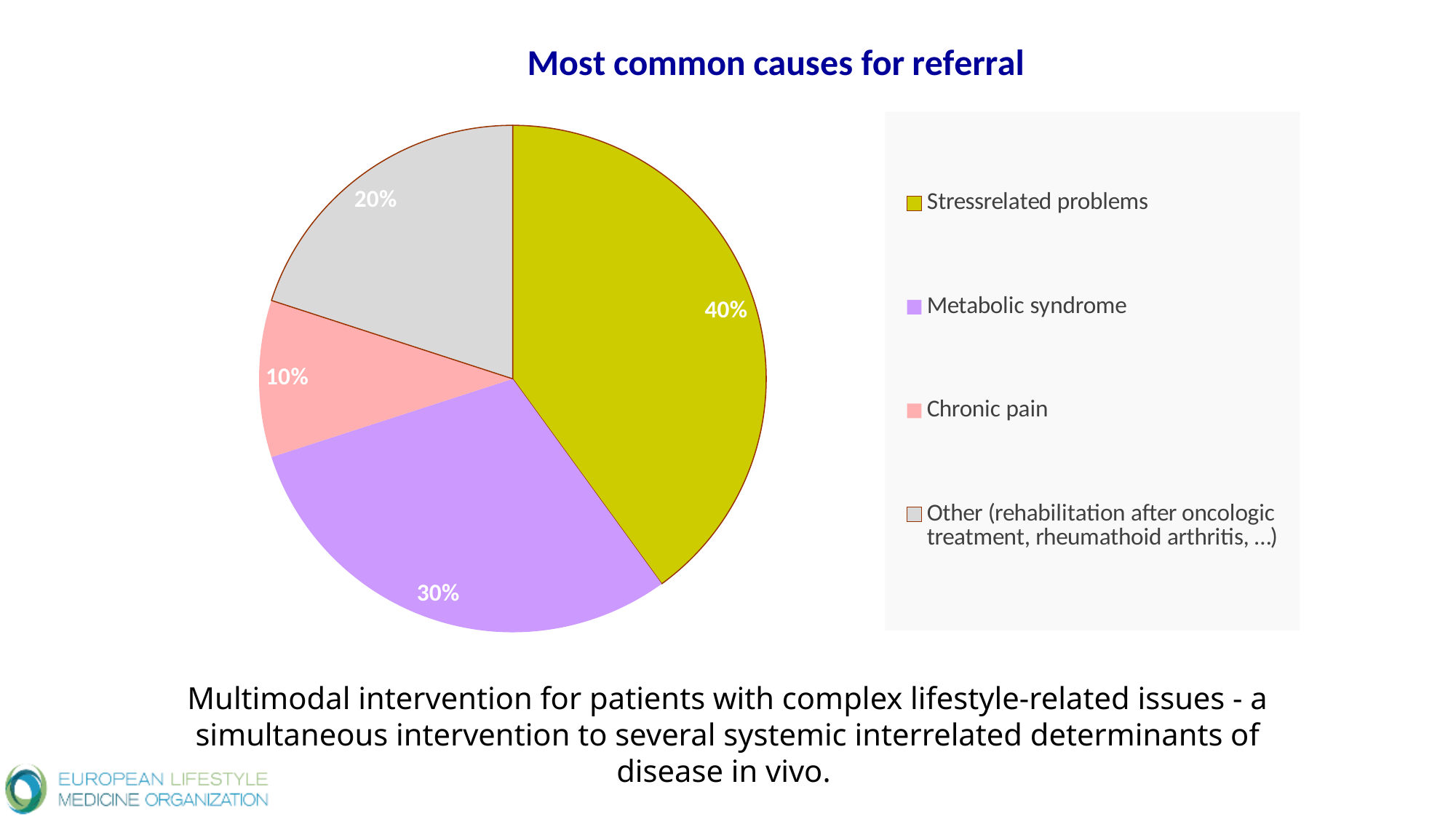
Which has a larger share, Chronic pain or Other? Other What is the title of the chart? Most common causes for referral What kind of chart is shown on the slide? pie chart Which cause for referral has the largest share? Stressrelated problems What share of referrals falls under Other (rehabilitation after oncologic treatment, rheumathoid arthritis, ...)? 20% What share of referrals is for Metabolic syndrome? 30% What share of referrals is for Chronic pain? 10% What share of referrals is for Stressrelated problems? 40% How many slices does the pie chart have? 4 Which cause for referral has the smallest share? Chronic pain What colour is the slice for Metabolic syndrome? purple What is the difference in percentage points between Stressrelated problems and Metabolic syndrome? 10 percentage points